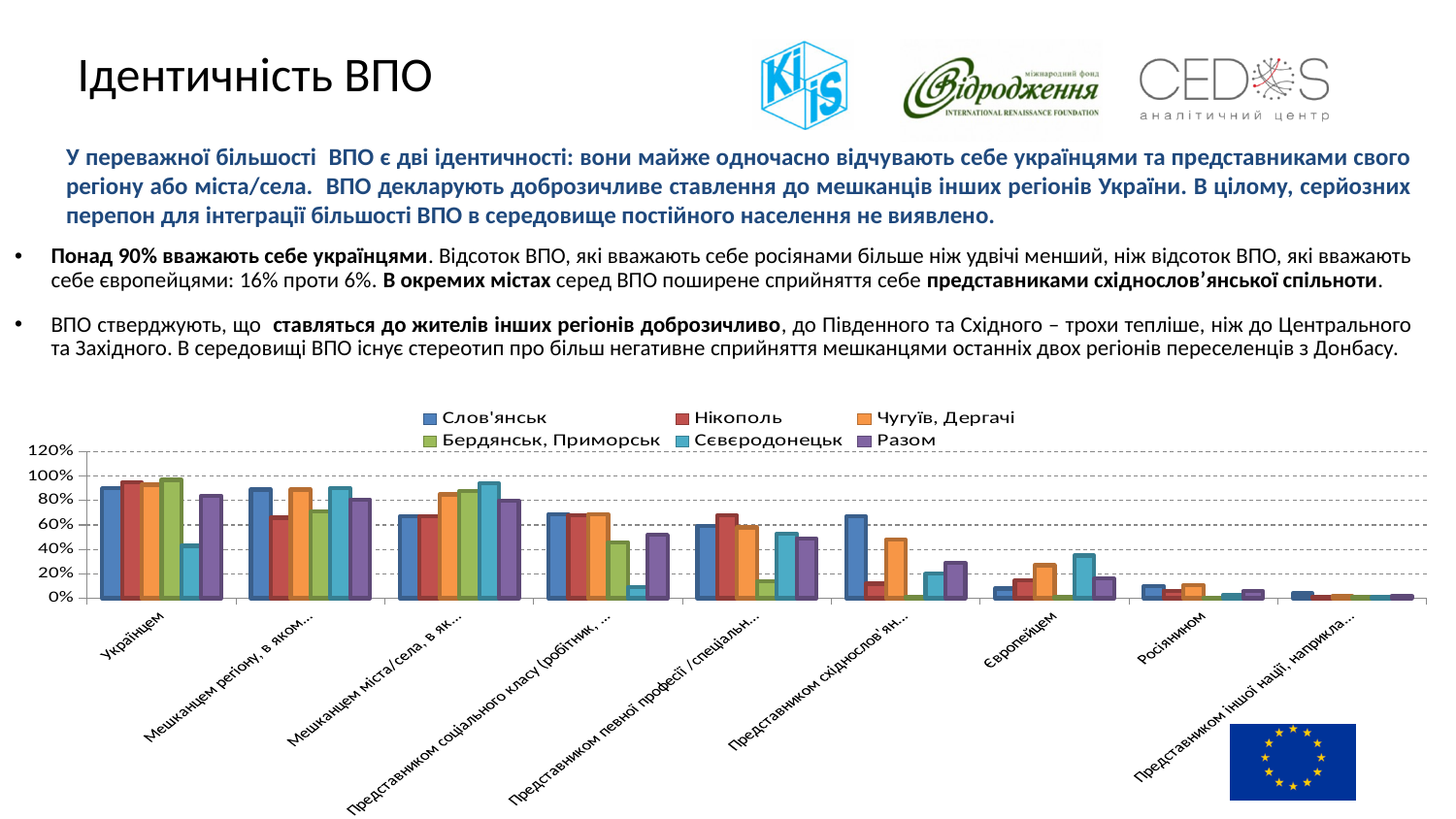
What kind of chart is shown on the slide? bar chart Is the value for Разом in the category Росіянином greater or less than 20%? less In the category Українцем, which is larger: the value for Слов'янськ or the value for Сєвєродонецьк? Слов'янськ Is the value for Слов'янськ in the category Українцем greater or less than 80%? greater Which series is shown in purple in the chart legend? Разом In the category Українцем, which series has the lowest value? Сєвєродонецьк In the category Європейцем, which series has the highest value? Сєвєродонецьк Is the value for Сєвєродонецьк in the category Європейцем greater or less than 20%? greater For the series Разом, which is larger: the value for Європейцем or the value for Росіянином? Європейцем How many series does the chart legend list? 6 How many categories are shown along the x axis of the chart? 9